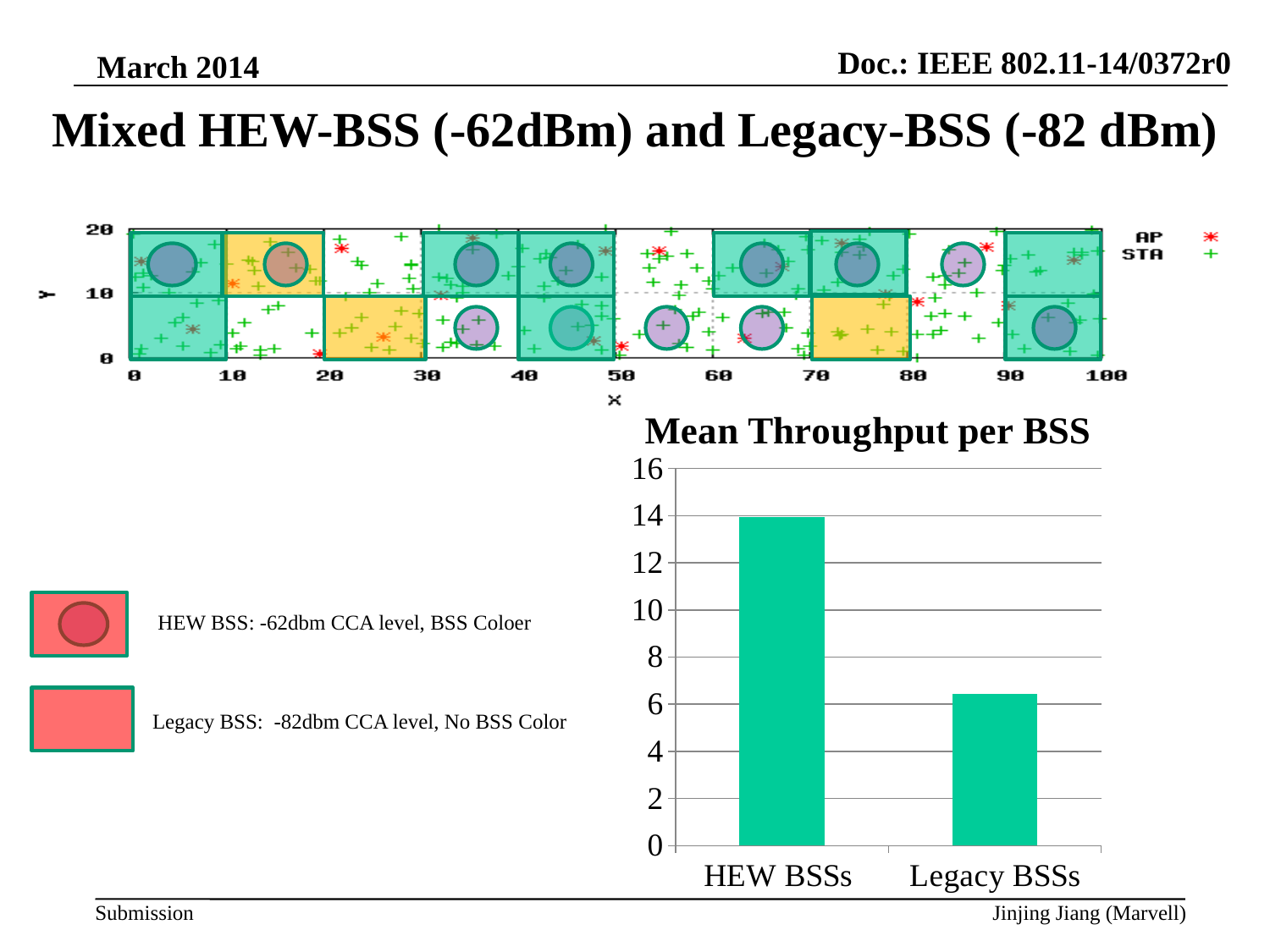
In the Mean Throughput per BSS chart, is the value for Legacy BSSs greater or less than 4? greater In the Mean Throughput per BSS chart, is the value for HEW BSSs greater or less than 12? greater In the Mean Throughput per BSS chart, is the value for HEW BSSs greater or less than 16? less In the Mean Throughput per BSS chart, which category has the highest bar? HEW BSSs What is the title of the bar chart on the slide? Mean Throughput per BSS In the Mean Throughput per BSS chart, which category has the lowest bar? Legacy BSSs How many categories are shown in the Mean Throughput per BSS chart? 2 In the Mean Throughput per BSS chart, which is larger, the value for HEW BSSs or the value for Legacy BSSs? HEW BSSs What kind of chart is the Mean Throughput per BSS chart? bar chart What is the maximum value shown on the vertical axis of the Mean Throughput per BSS chart? 16